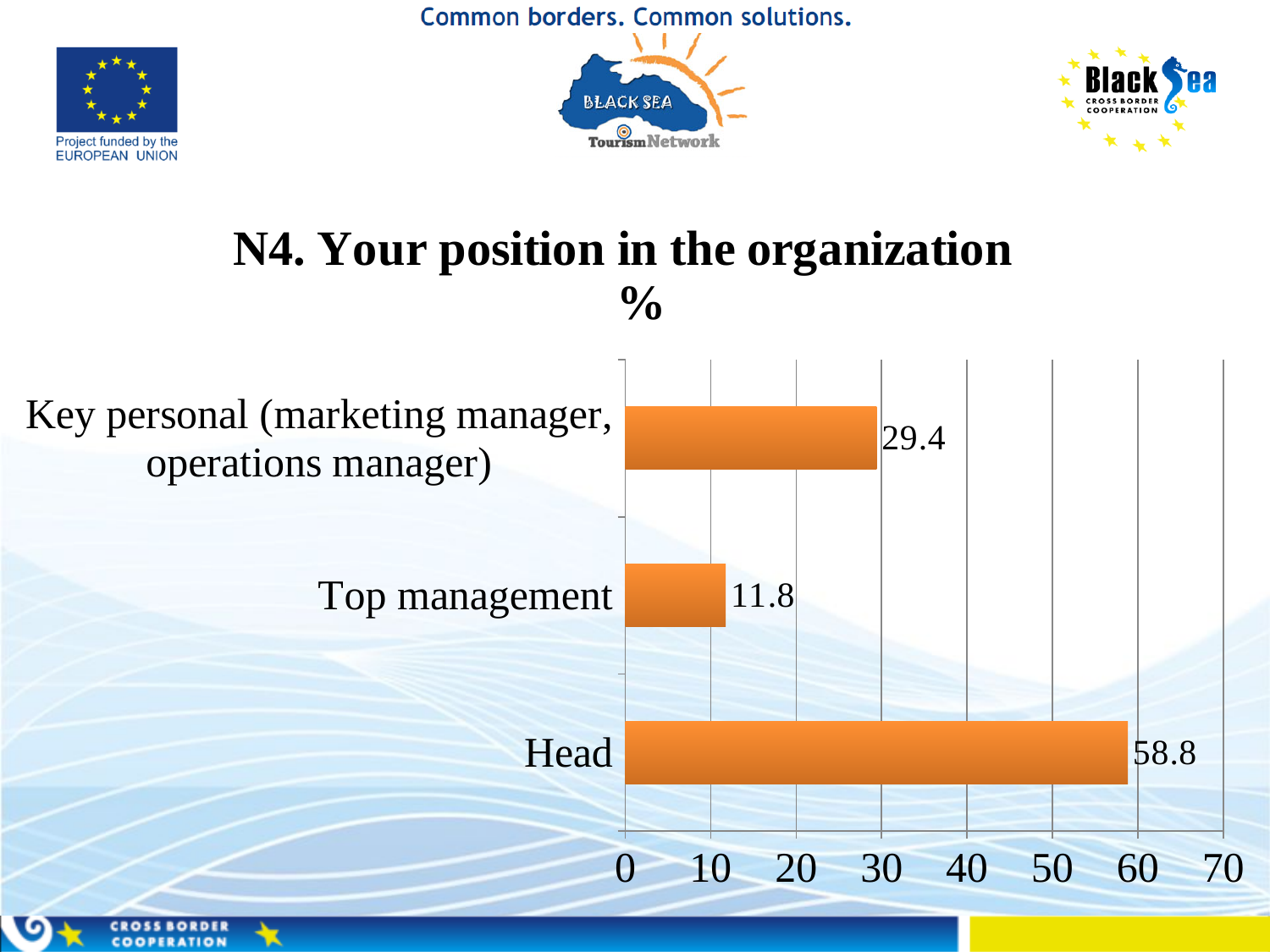
What is the difference between the values for Head and Top management? 47.0 Which is larger, the value for Head or the value for Key personal (marketing manager, operations manager)? Head What is the value for Key personal (marketing manager, operations manager)? 29.4 What is the title of the chart? N4. Your position in the organization % What is the value for Top management? 11.8 Which category has the lowest value? Top management What is the value for Head? 58.8 Which category has the highest value? Head What kind of chart is shown on the slide? bar chart How many categories are shown in the chart? 3 What is the difference between the values for Key personal (marketing manager, operations manager) and Top management? 17.6 Is the value for Head greater or less than 50? greater